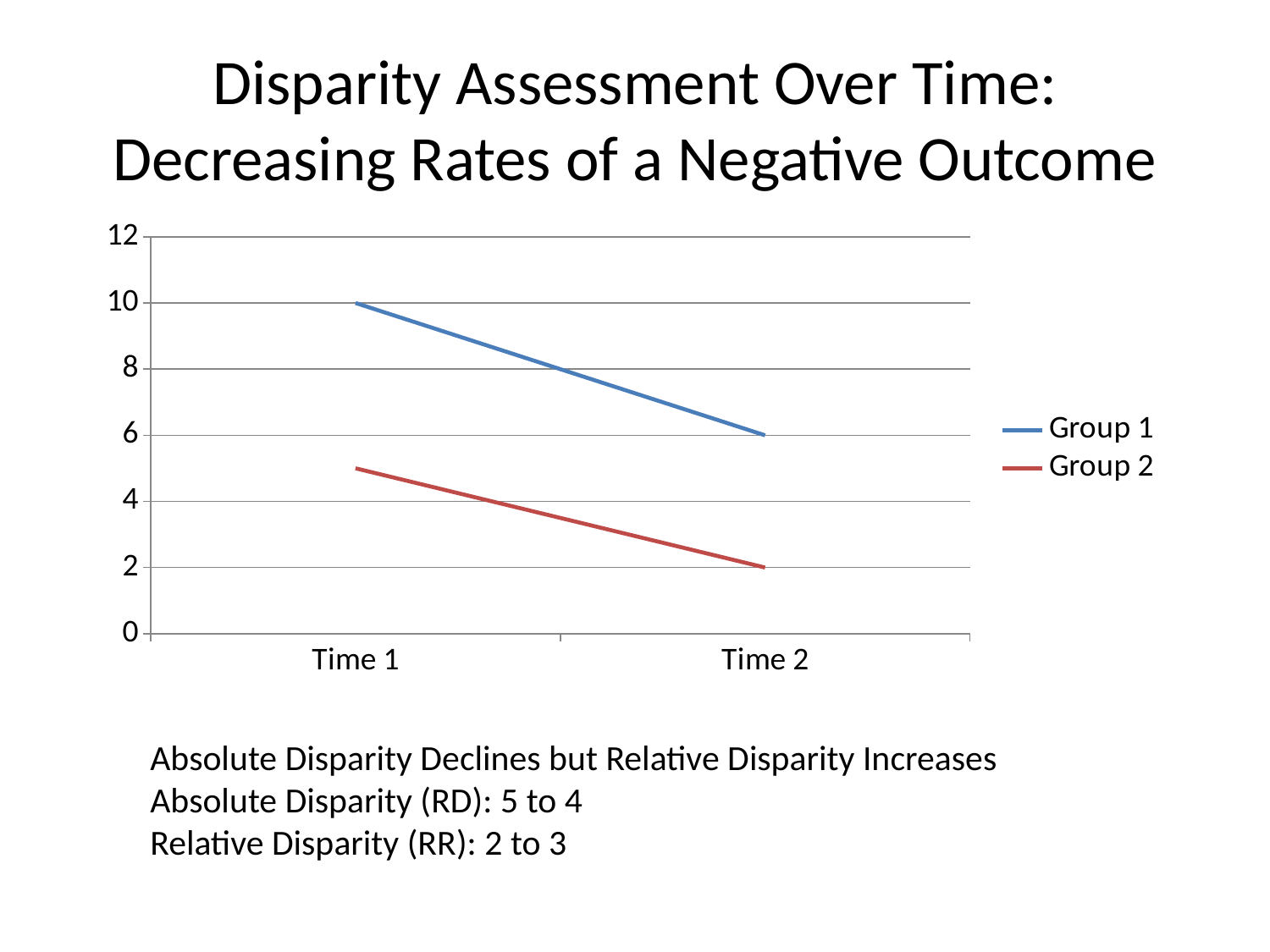
Do the values for Group 2 rise or fall from Time 1 to Time 2? Fall Is the value for Group 2 at Time 1 greater or less than 4? greater By how much does the value for Group 1 fall from Time 1 to Time 2? 4 Is the value for Group 2 at Time 1 greater or less than 6? less Which group has the higher value at Time 2? Group 1 How many series does the legend list? 2 What is the value for Group 2 at Time 2? 2 What kind of chart is shown on the slide? Line chart What is the value for Group 1 at Time 1? 10 What is the difference between Group 1 and Group 2 at Time 2? 4 How many time points are shown on the x axis? 2 What is the value for Group 1 at Time 2? 6